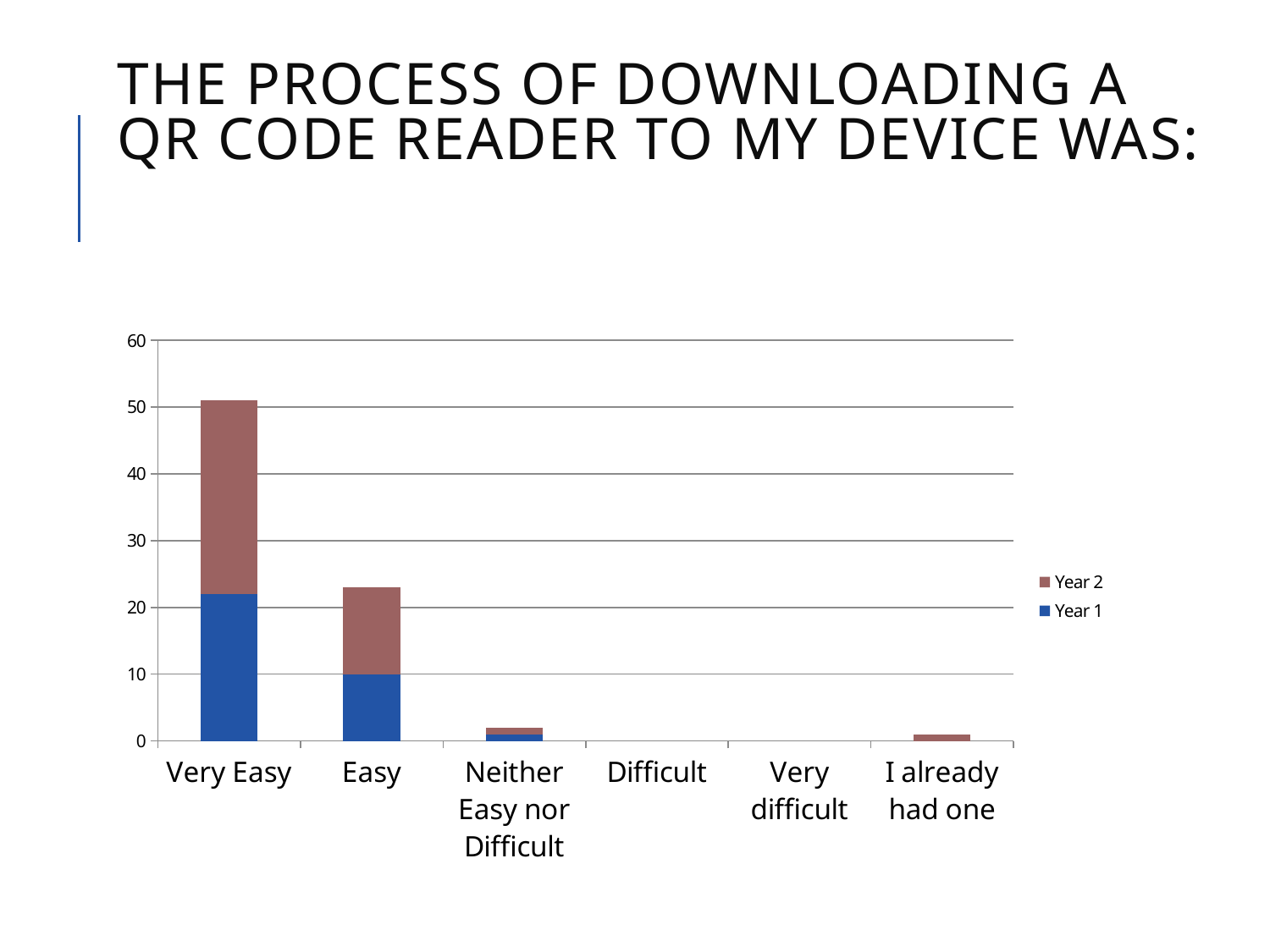
What is the title of the slide containing the chart? The process of downloading a QR code reader to my device was: Is the Year 1 value for Very Easy greater or less than 20? greater Which category has the tallest stacked bar? Very Easy What kind of chart is shown on the slide? stacked bar chart Is the total stacked value for Easy greater or less than 30? less Which stacked bar is taller, Very Easy or Easy? Very Easy Is the total stacked value for Neither Easy nor Difficult greater or less than 10? less Which series is shown in blue in the chart's legend? Year 1 How many series does the chart's legend list? 2 Which category has a larger Year 2 value, Easy or I already had one? Easy How many categories are shown on the x axis of the chart? 6